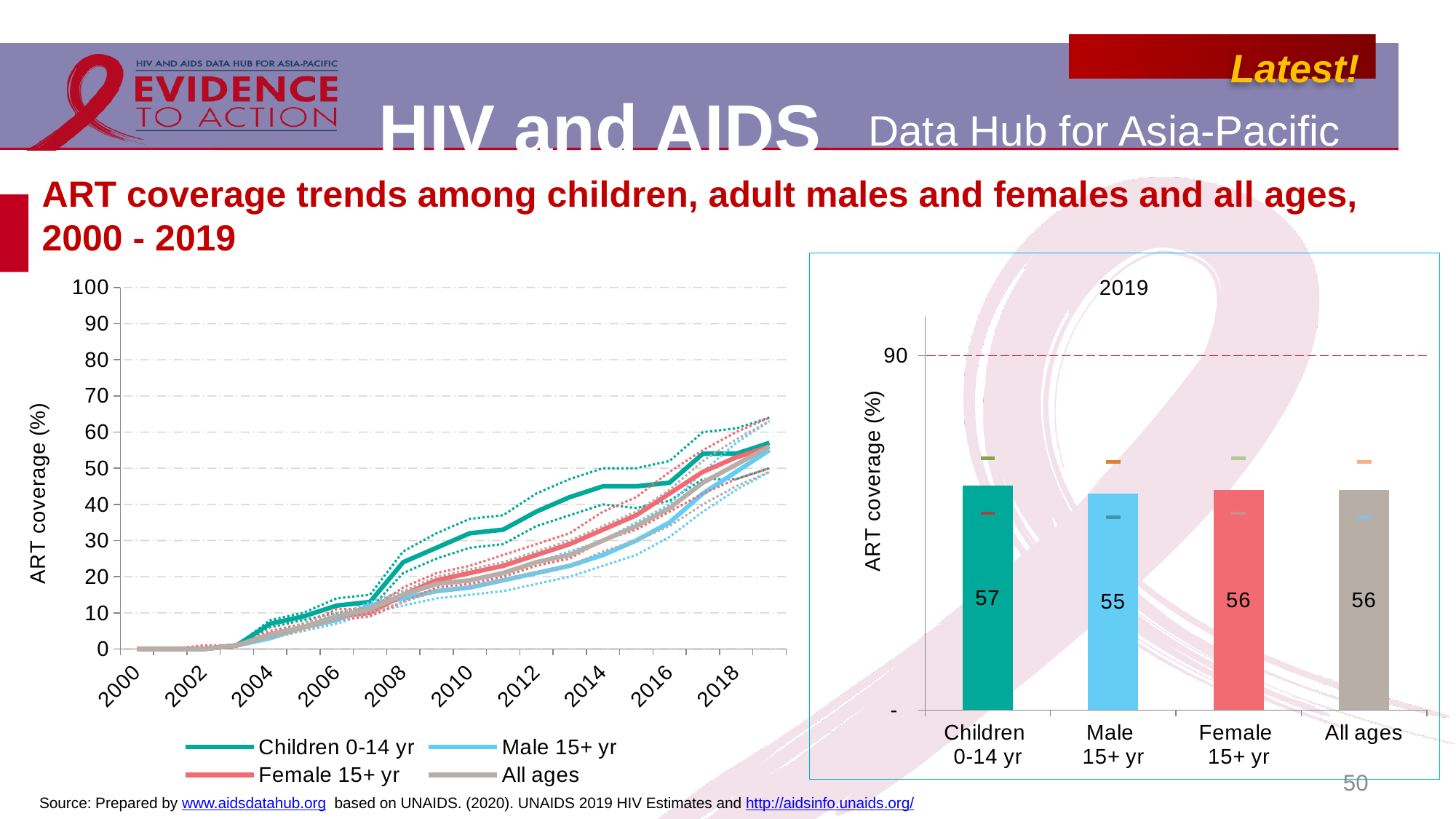
What kind of chart is the chart on the left showing ART coverage from 2000 to 2019? line chart In the bar chart on the right titled 2019, which group has the lowest ART coverage? Male 15+ yr In the bar chart on the right titled 2019, how many groups are shown on the x axis? 4 In the bar chart on the right titled 2019, which group has the highest ART coverage? Children 0-14 yr In the line chart on the left, does ART coverage for All ages rise or fall from 2000 to 2019? rise In the bar chart on the right titled 2019, what is the difference between the ART coverage for Children 0-14 yr and Male 15+ yr? 2 In the bar chart on the right titled 2019, what is the ART coverage for Female 15+ yr? 56 In the bar chart on the right titled 2019, what is the ART coverage for Children 0-14 yr? 57 In the bar chart on the right titled 2019, what is the ART coverage for Male 15+ yr? 55 In the line chart on the left, how many series does the legend list? 4 In the bar chart on the right titled 2019, what value does the dashed horizontal line mark on the y axis? 90 In the line chart on the left, is the value for Children 0-14 yr in 2014 greater or less than 40? greater